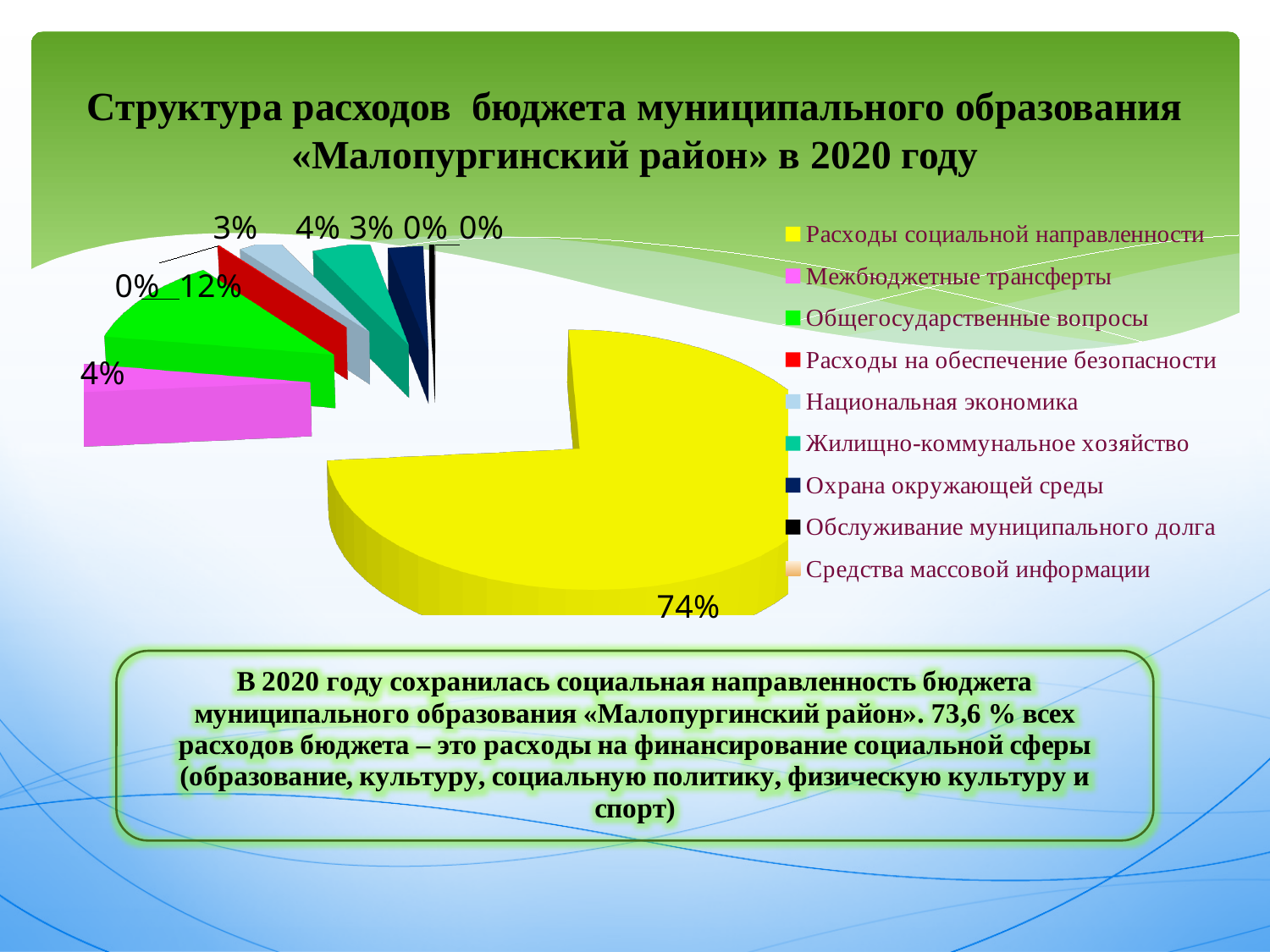
What is the title of the chart on the slide? Структура расходов бюджета муниципального образования «Малопургинский район» в 2020 году Which is larger: «Общегосударственные вопросы» or «Межбюджетные трансферты»? Общегосударственные вопросы Which category has the largest slice of the pie? Расходы социальной направленности What percentage is shown for «Общегосударственные вопросы»? 12% What type of chart is shown on the slide? Pie chart What percentage is shown for «Межбюджетные трансферты»? 4% By how many percentage points does «Расходы социальной направленности» exceed «Общегосударственные вопросы»? 62 percentage points What share of the budget expenditures is labelled for «Расходы социальной направленности»? 74% How many categories does the legend of the pie chart list? 9 What percentage is shown for «Охрана окружающей среды»? 3% What percentage is shown for «Расходы на обеспечение безопасности»? 0% What colour is the largest slice of the pie? Yellow